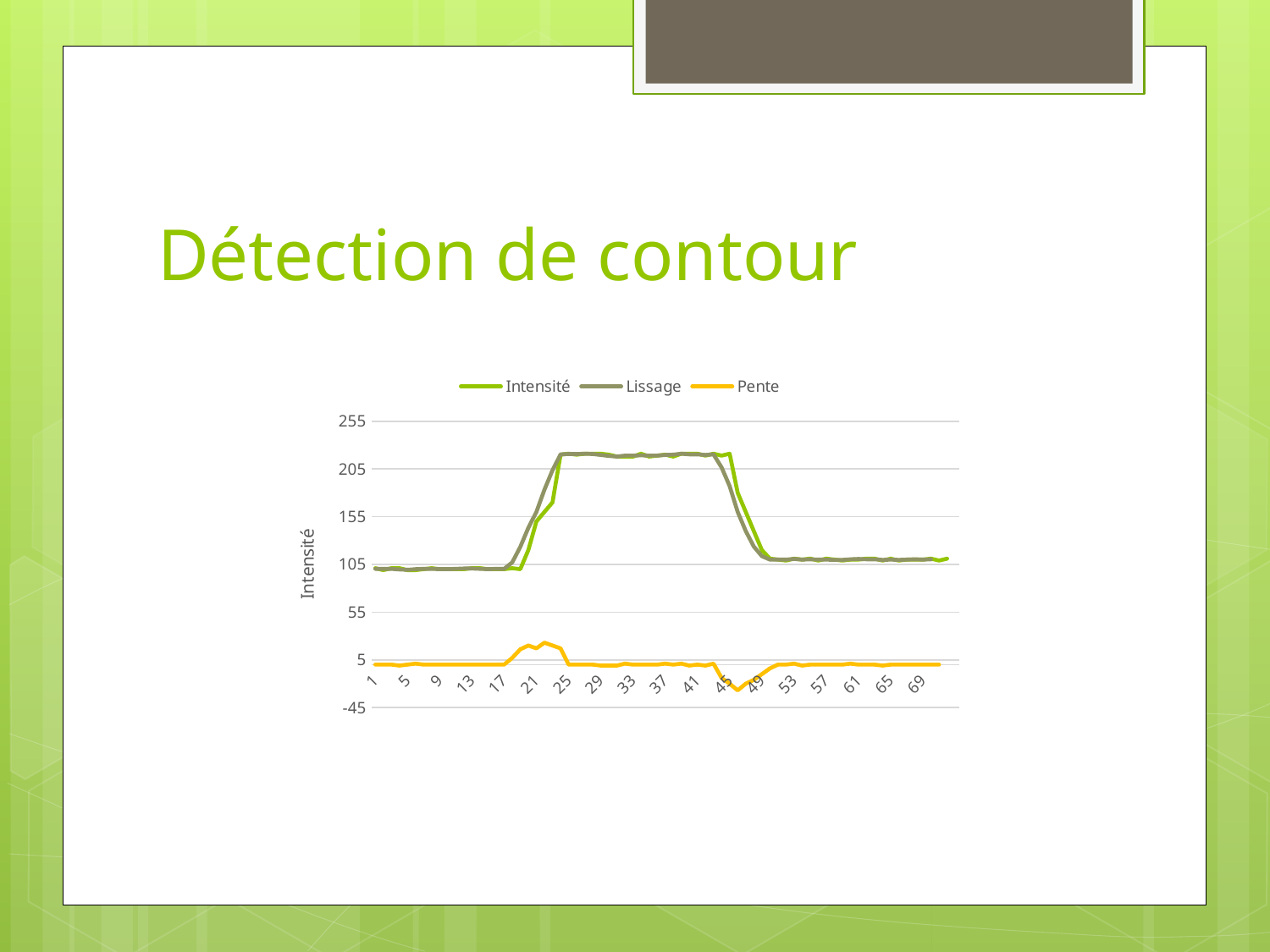
Is the value of Lissage at x = 29 greater or less than 205? greater Does the Intensité series rise or fall between x = 45 and x = 53? fall Is the value of Intensité at x = 9 greater or less than 155? less What are the names of the series listed in the legend? Intensité, Lissage, Pente Is the value of Pente at x = 47 greater or less than 5? less What kind of chart is shown on the slide? line chart Which is larger: the Intensité value at x = 33 or at x = 9? x = 33 What is the title of the vertical axis? Intensité Does the Intensité series rise or fall between x = 17 and x = 25? rise How many series does the legend list? 3